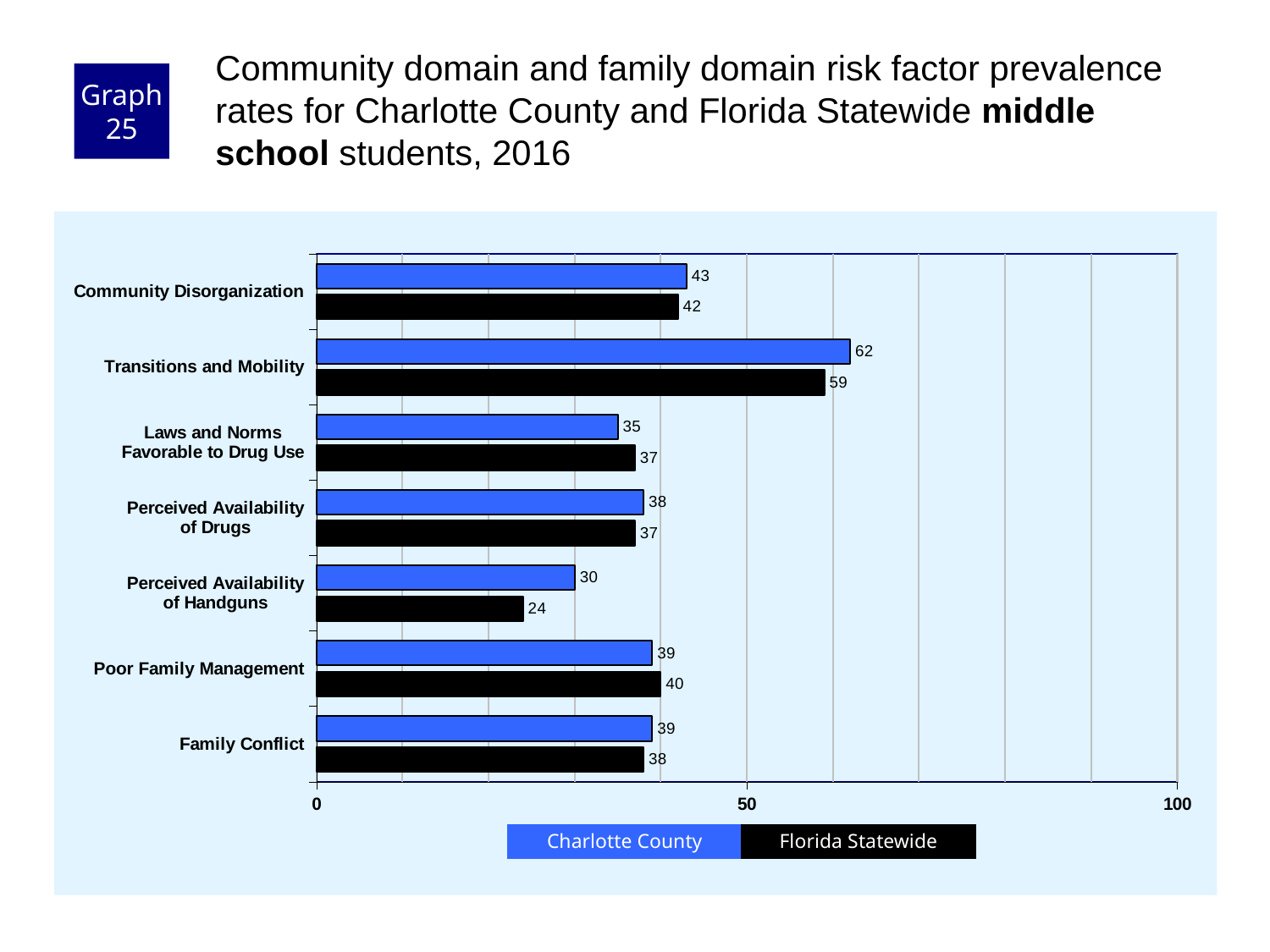
Which risk factor has the highest Charlotte County value? Transitions and Mobility How many series does the legend list? 2 Which colour represents Florida Statewide in the chart? Black Is the Florida Statewide value for Transitions and Mobility greater or less than 50? greater What is the Florida Statewide value for Poor Family Management? 40 What kind of chart is shown on the slide? Bar chart Which risk factor has the lowest Florida Statewide value? Perceived Availability of Handguns How many risk factor categories are shown on the chart? 7 What is the difference between the Charlotte County and Florida Statewide values for Perceived Availability of Handguns? 6 What is the Charlotte County value for Transitions and Mobility? 62 What is the Florida Statewide value for Perceived Availability of Handguns? 24 For Laws and Norms Favorable to Drug Use, which is larger: the Charlotte County value or the Florida Statewide value? Florida Statewide